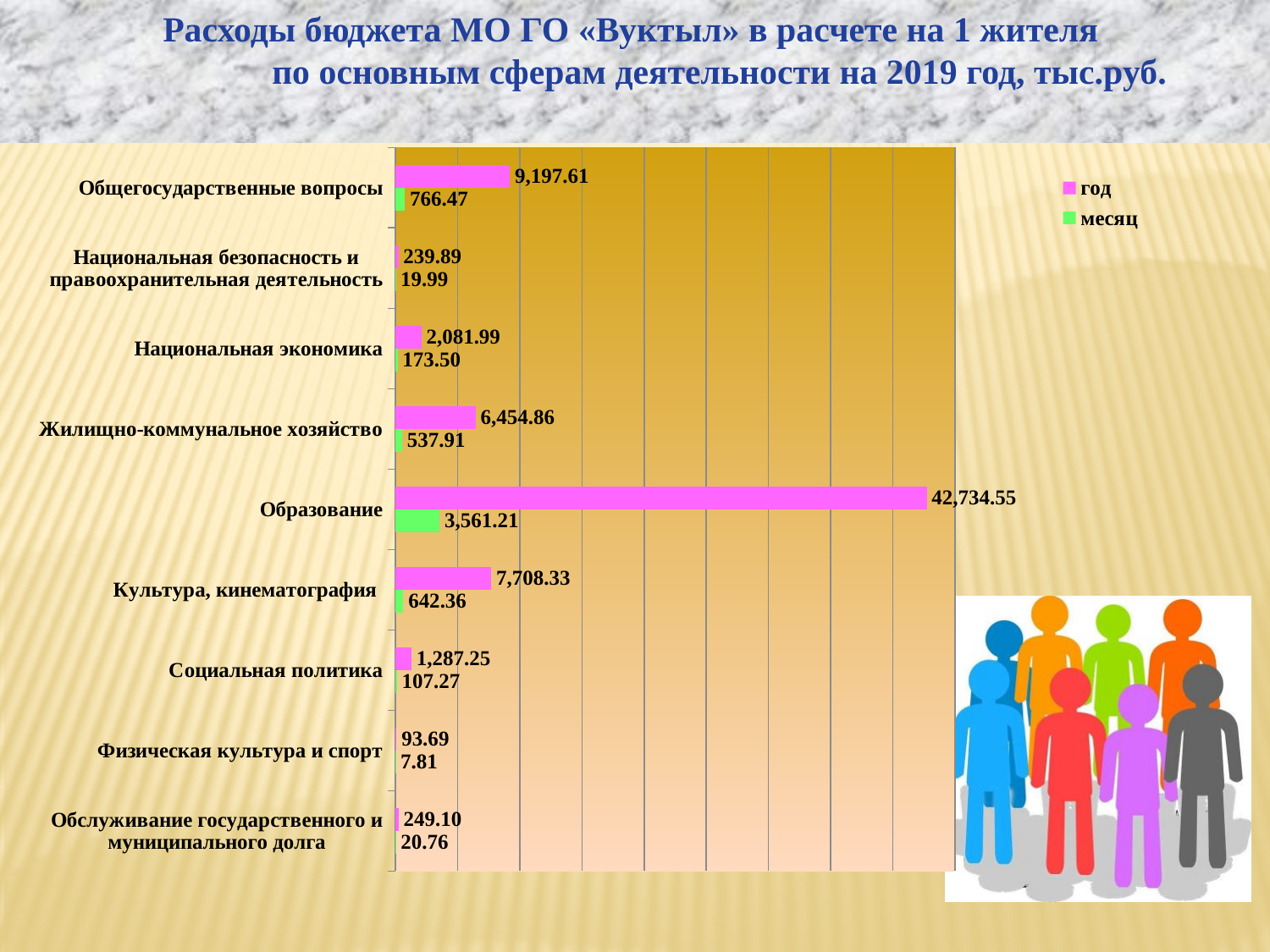
What is the value of the "месяц" series for Жилищно-коммунальное хозяйство? 537.91 What kind of chart is shown on the slide? Bar chart What is the value of the "месяц" series for Физическая культура и спорт? 7.81 What are the two legend entries of the chart? год and месяц How many categories are shown on the chart? 9 What is the value of the "год" series for Образование? 42,734.55 What is the difference between the "год" and "месяц" values for Общегосударственные вопросы? 8,431.14 Which category has the highest value in the "год" series? Образование Which category has the lowest value in the "месяц" series? Физическая культура и спорт How many series does the legend list? 2 Which has the larger "год" value: Общегосударственные вопросы or Жилищно-коммунальное хозяйство? Общегосударственные вопросы What is the value of the "год" series for Культура, кинематография? 7,708.33